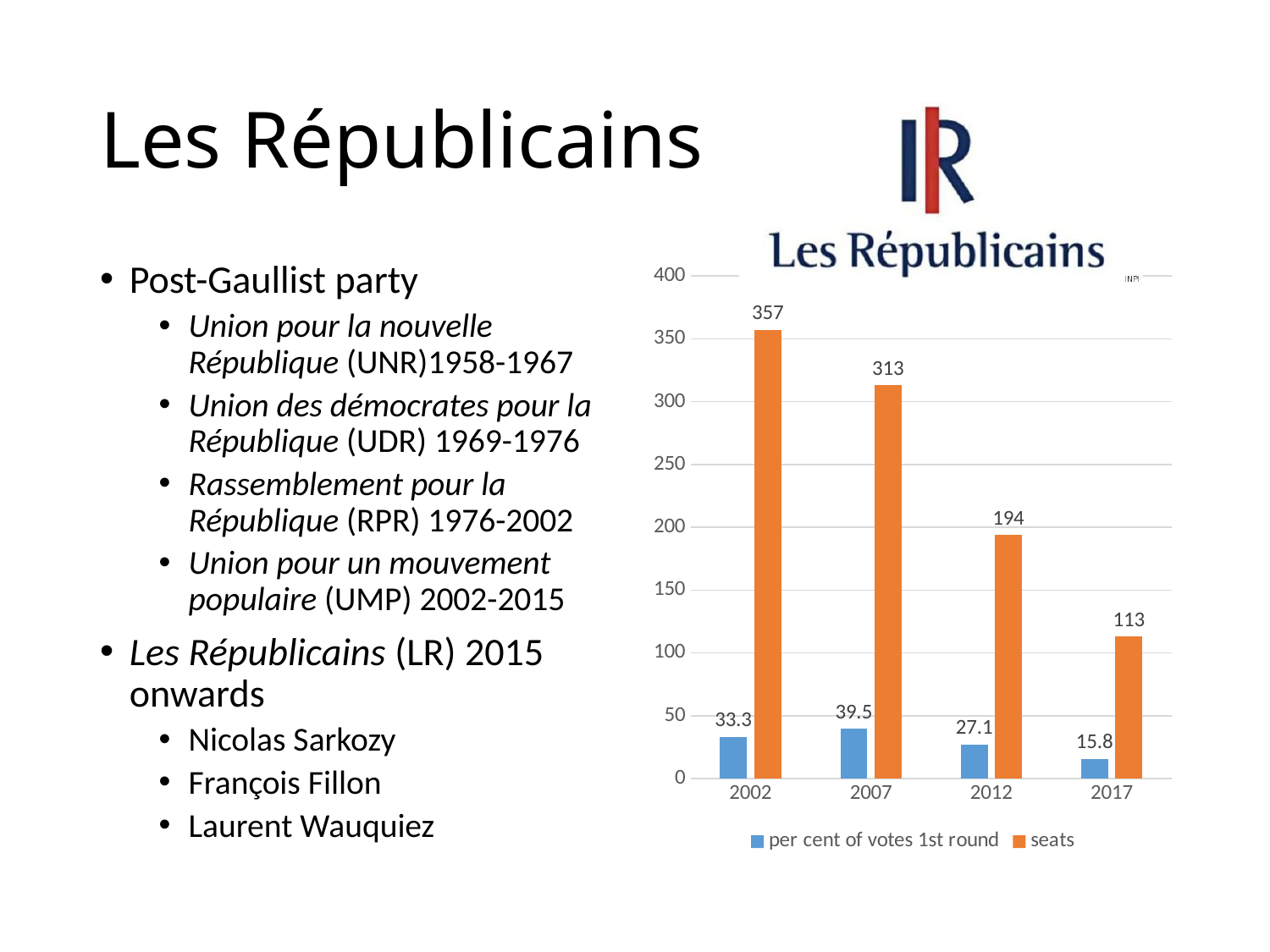
How many seats did the party win in 2002? 357 How many series does the legend list? 2 What is the difference in seats between 2007 and 2012? 119 In which year was the number of seats highest? 2002 How many years are shown on the x axis? 4 Do the seats rise or fall from 2002 to 2017? fall How many seats are shown for 2017? 113 In which year was the per cent of votes in the 1st round lowest? 2017 Which colour represents the seats series? orange Which year had more seats, 2012 or 2017? 2012 What was the per cent of votes in the 1st round in 2007? 39.5 What kind of chart is shown on the slide? bar chart